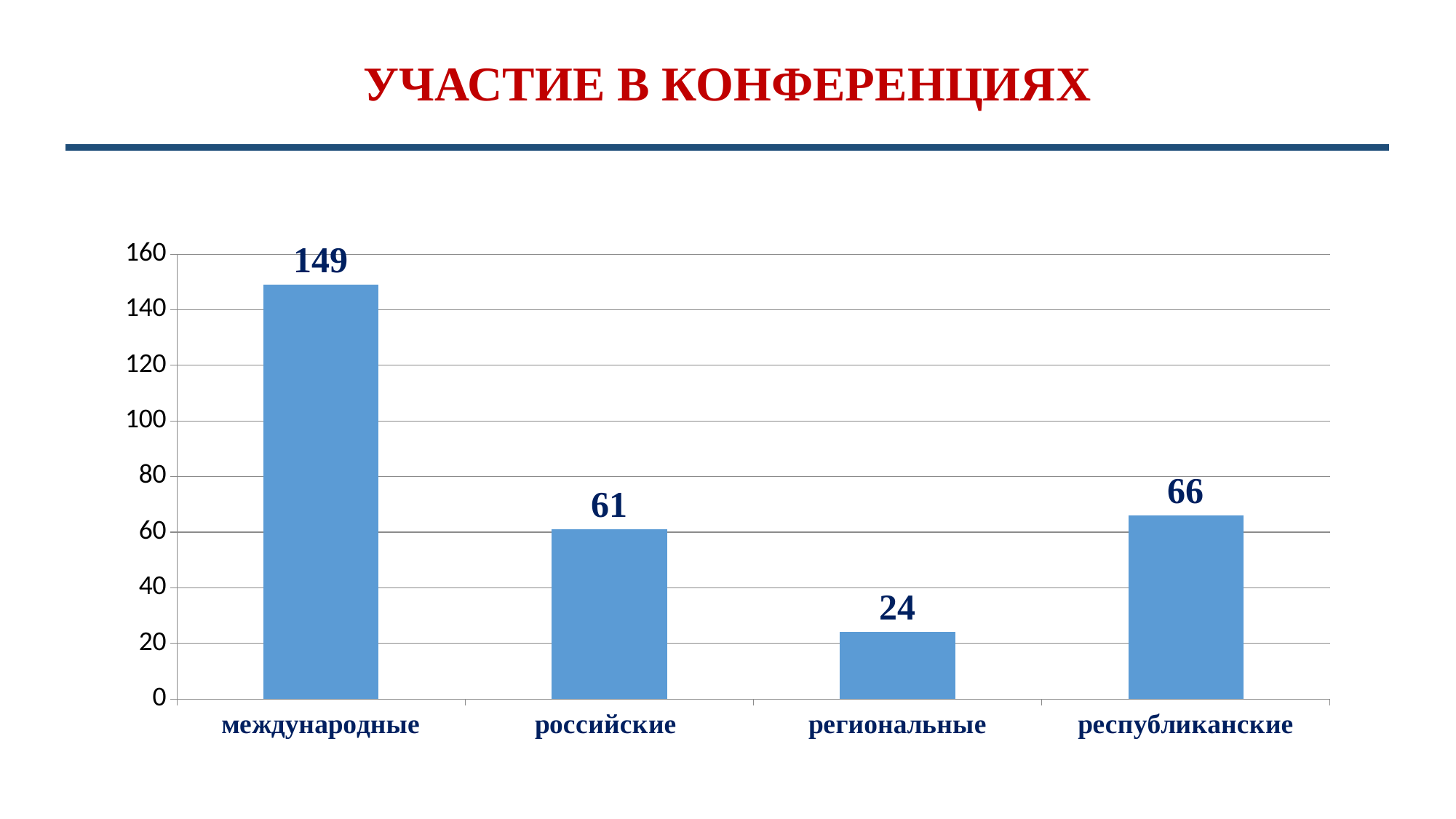
Which category has the lowest value? региональные Is the value for международные greater or less than 140? greater What is the value for российские? 61 Which is larger, the value for республиканские or the value for российские? республиканские What is the value for республиканские? 66 What kind of chart is shown on the slide? bar chart What is the value for международные? 149 What is the difference between the values for международные and российские? 88 How many categories are shown on the chart? 4 Which category has the highest value? международные What is the title of the slide? УЧАСТИЕ В КОНФЕРЕНЦИЯХ What is the value for региональные? 24